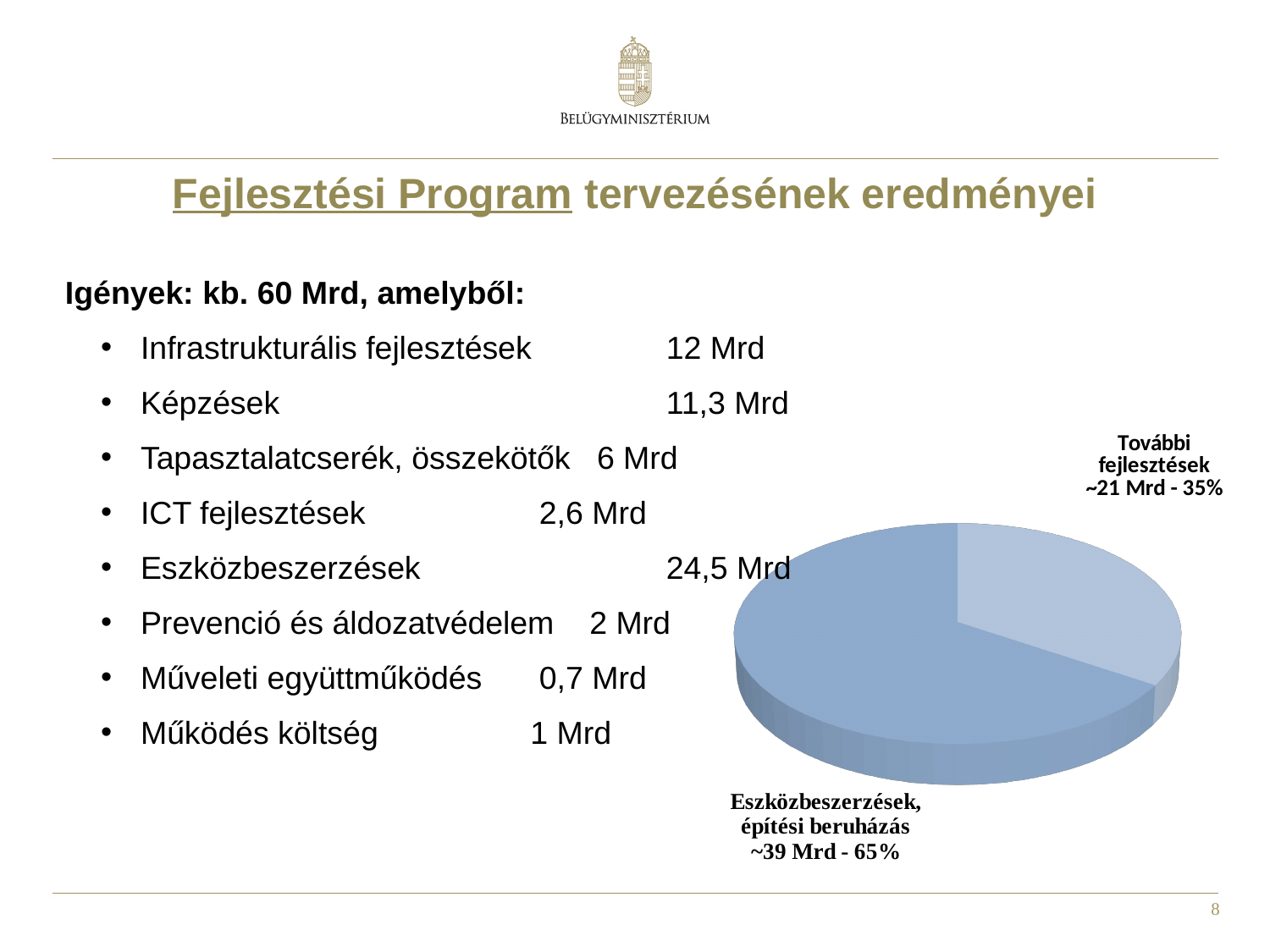
Which is larger in the pie chart: "Eszközbeszerzések, építési beruházás" or "További fejlesztések"? Eszközbeszerzések, építési beruházás What share of the pie does the slice labelled "További fejlesztések" represent? 35% By how many percentage points does the "Eszközbeszerzések, építési beruházás" share exceed the "További fejlesztések" share? 30 percentage points What kind of chart is shown on the slide? pie chart What share of the pie does the slice labelled "Eszközbeszerzések, építési beruházás" represent? 65% What do the two percentage shares shown on the pie chart add up to? 100% How many slices does the pie chart have? 2 Which slice of the pie chart is the smallest? További fejlesztések Is the pie chart drawn with a 3D effect? yes Which slice of the pie chart is the largest? Eszközbeszerzések, építési beruházás Which slice of the pie chart is drawn in the lighter shade of blue? További fejlesztések